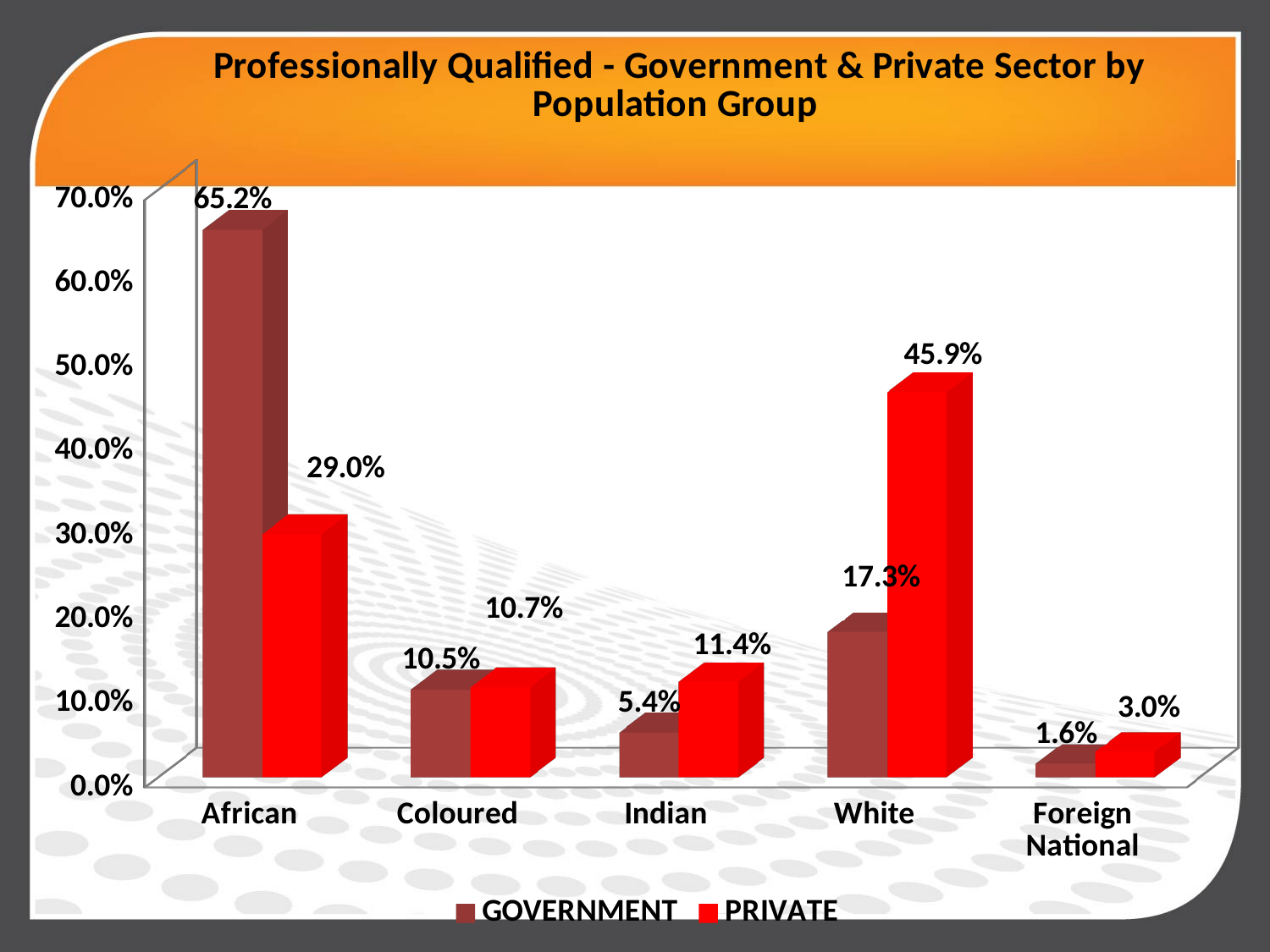
Which population group has the lowest PRIVATE value? Foreign National What is the GOVERNMENT value for African? 65.2% What is the difference between the GOVERNMENT and PRIVATE values for African? 36.2% How many series does the legend list? 2 What kind of chart is shown on the slide? Bar chart Which is larger for White: the GOVERNMENT value or the PRIVATE value? PRIVATE What is the title of the chart? Professionally Qualified - Government & Private Sector by Population Group Which population group has the highest GOVERNMENT value? African How many population groups are shown on the x axis? 5 What is the PRIVATE value for Indian? 11.4% What is the PRIVATE value for White? 45.9% What is the GOVERNMENT value for Foreign National? 1.6%